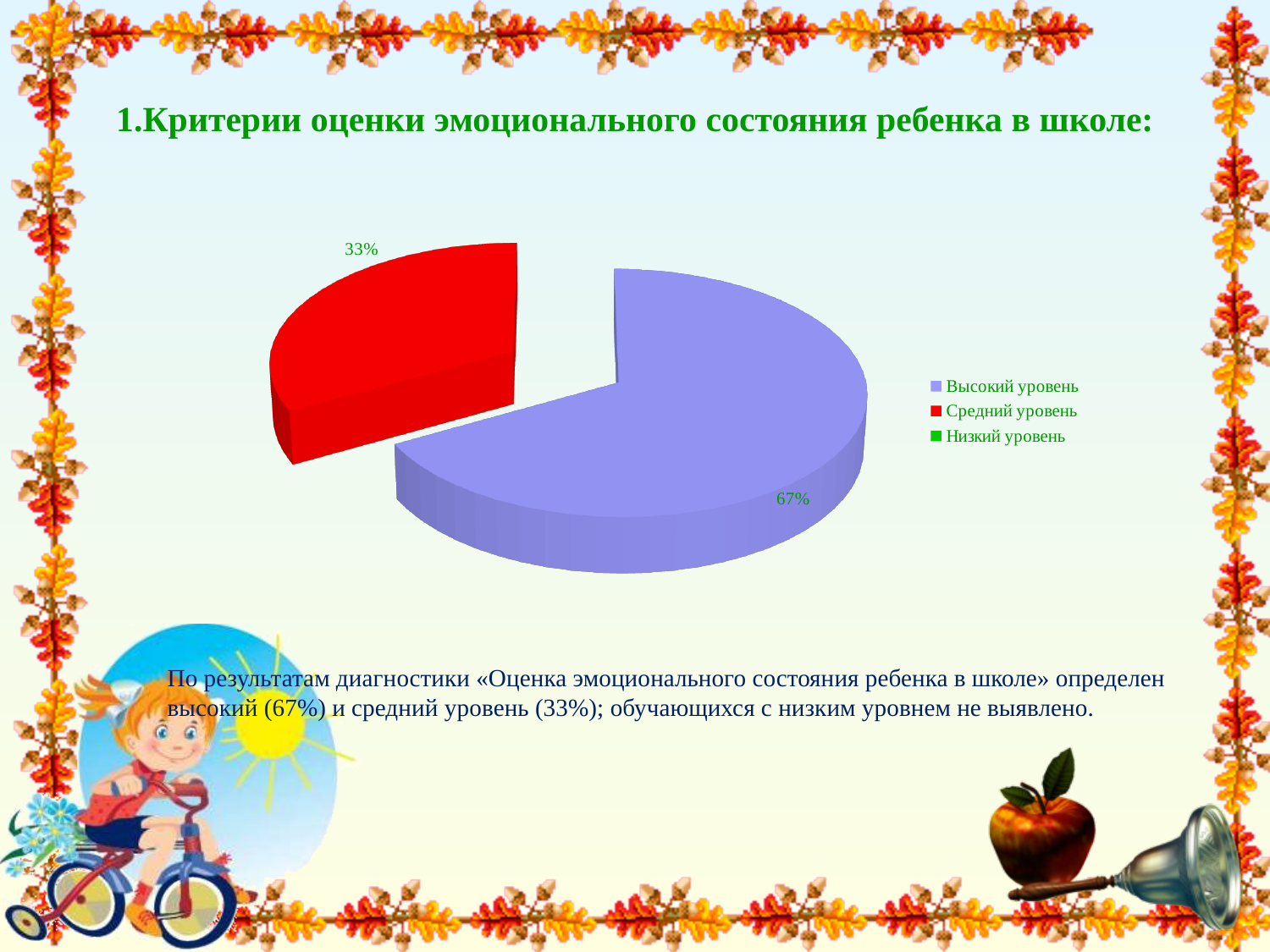
How many entries does the legend list? 3 Which of the two visible slices is larger, "Высокий уровень" or "Средний уровень"? Высокий уровень What share of the pie does "Высокий уровень" have? 67% Which legend entry has no visible slice in the pie? Низкий уровень Which category has the largest slice of the pie? Высокий уровень Is the share for "Высокий уровень" greater or less than 50%? greater What colour is the slice for "Средний уровень"? red What kind of chart is shown on the slide? pie chart What is the difference in percentage points between "Высокий уровень" and "Средний уровень"? 34 What share of the pie does "Средний уровень" have? 33%